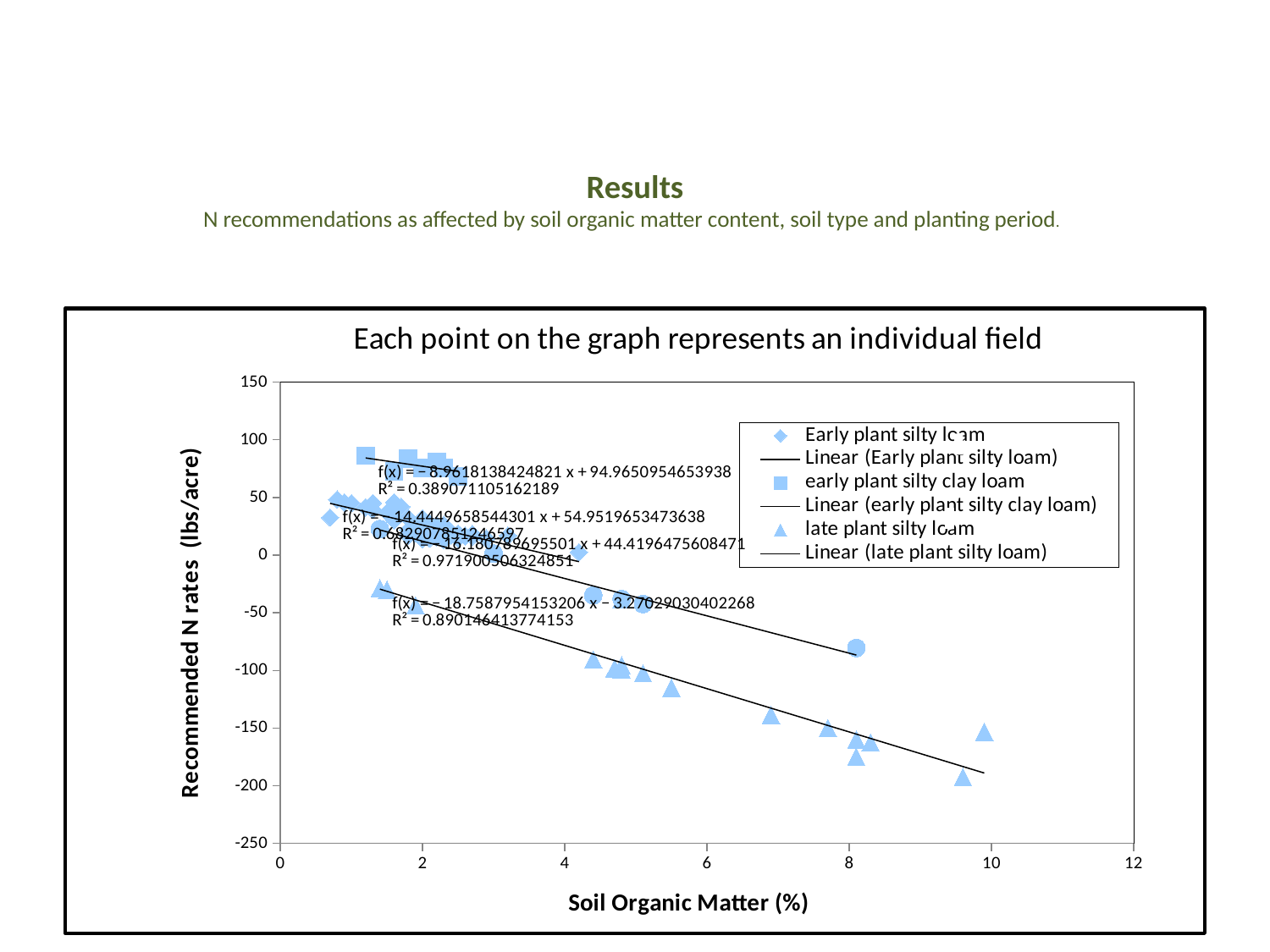
Which series has the highest recommended N rates on the chart? early plant silty clay loam Is the value for the late plant silty loam point at about 4.4% soil organic matter greater or less than -50? less What is the label of the x axis? Soil Organic Matter (%) Is the value for the early plant silty clay loam point at about 1.2% soil organic matter greater or less than 50? greater How many tick marks are labelled on the x axis? 7 What kind of chart is shown on the slide? scatter chart Which series has the lowest recommended N rates on the chart? late plant silty loam As soil organic matter increases along the x axis, do the recommended N rates rise or fall? fall Is the value for the late plant silty loam point at about 9.6% soil organic matter greater or less than -150? less What is the title of the chart? Each point on the graph represents an individual field How many entries does the chart legend list? 6